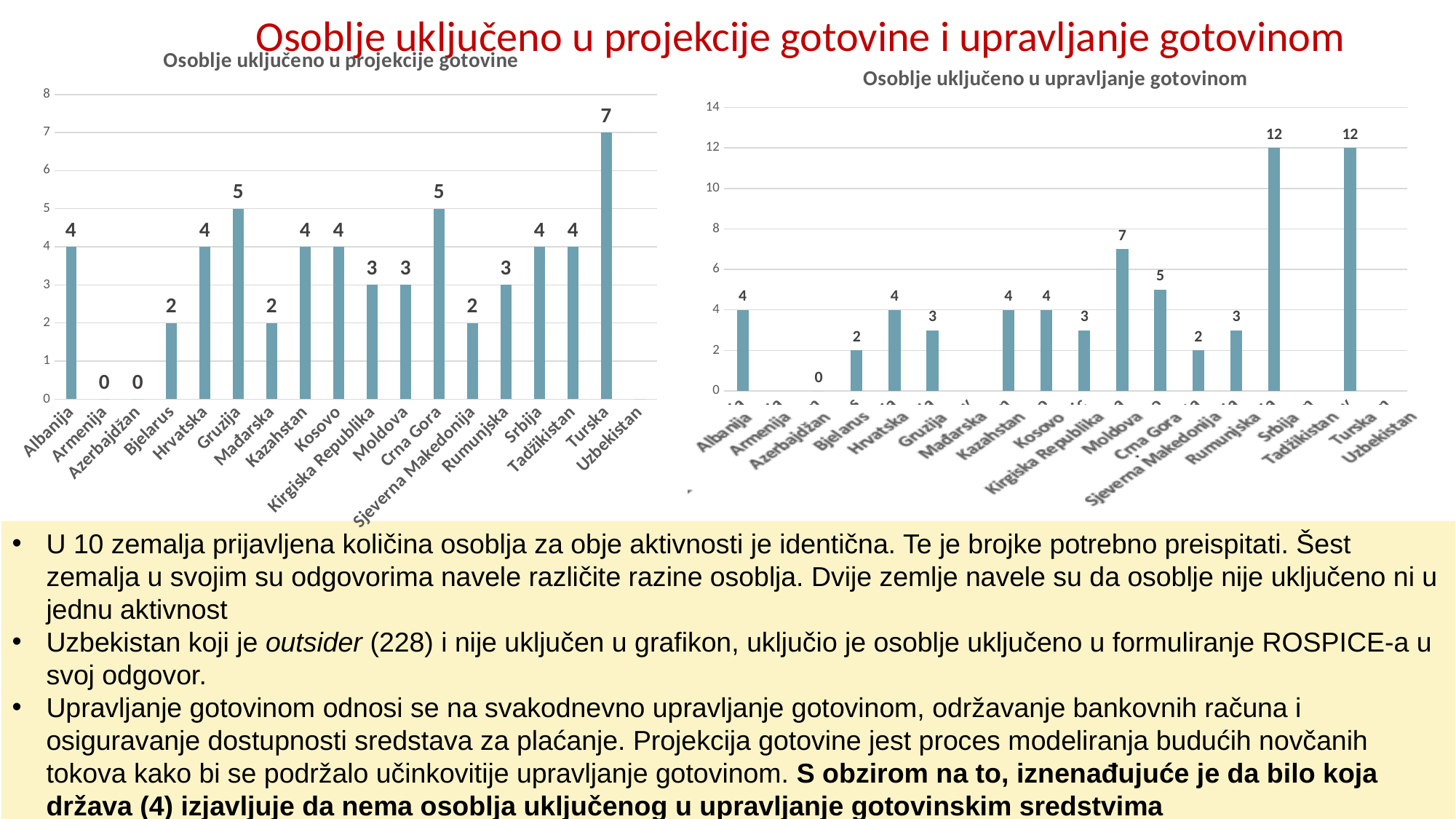
In the chart titled 'Osoblje uključeno u projekcije gotovine', which country has the highest value? Turska How many countries are listed on the x axis of the chart titled 'Osoblje uključeno u projekcije gotovine'? 18 In the chart titled 'Osoblje uključeno u projekcije gotovine', which is larger, the value for Bjelarus or the value for Kosovo? Kosovo In the chart titled 'Osoblje uključeno u upravljanje gotovinom', which is larger, the value for Crna Gora or the value for Gruzija? Crna Gora In the chart titled 'Osoblje uključeno u projekcije gotovine', what is the difference between the values for Turska and Crna Gora? 2 In the chart titled 'Osoblje uključeno u upravljanje gotovinom', what is the value for Moldova? 7 In the chart titled 'Osoblje uključeno u upravljanje gotovinom', what is the value for Srbija? 12 What kind of chart is the chart titled 'Osoblje uključeno u projekcije gotovine'? Bar chart In the chart titled 'Osoblje uključeno u projekcije gotovine', what is the value for Gruzija? 5 In the chart titled 'Osoblje uključeno u projekcije gotovine', what is the value for Turska? 7 In the chart titled 'Osoblje uključeno u upravljanje gotovinom', what is the difference between the values for Turska and Moldova? 5 In the chart titled 'Osoblje uključeno u upravljanje gotovinom', is the value for Srbija greater or less than 10? greater